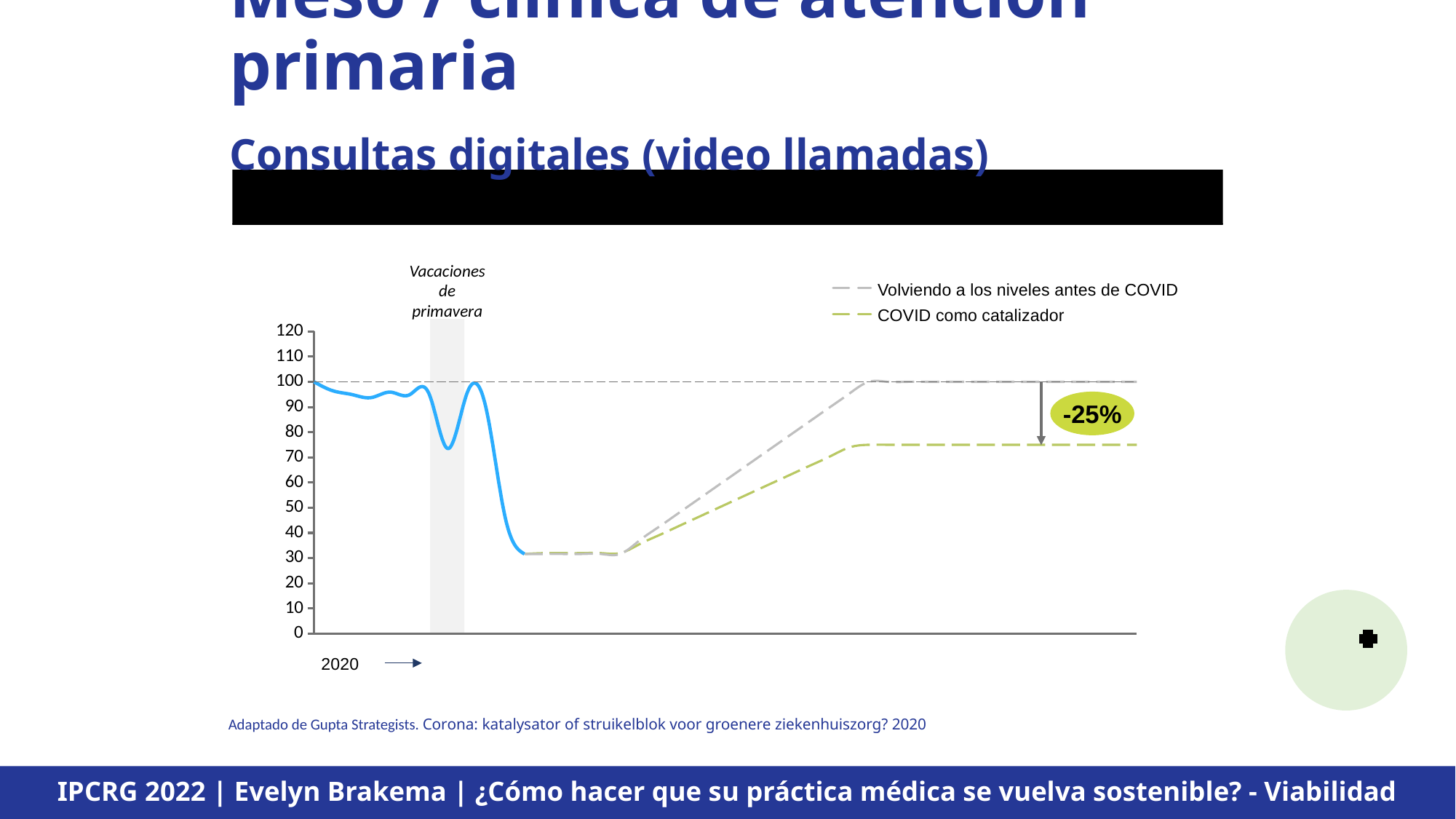
Is the final value of the 'COVID como catalizador' line greater or less than 70? greater Is the final value of the 'COVID como catalizador' line greater or less than 80? less Is the lowest plateau of the blue line after the spring holidays greater or less than 40? less What kind of chart is shown on the slide? line chart What label is given to the shaded vertical band on the chart? Vacaciones de primavera What are the two series named in the legend? Volviendo a los niveles antes de COVID; COVID como catalizador What percentage is printed in the yellow oval annotation on the chart? -25% How many series does the legend list? 2 Which series ends at a higher level on the right of the chart, 'Volviendo a los niveles antes de COVID' or 'COVID como catalizador'? Volviendo a los niveles antes de COVID What is the highest value shown on the y axis? 120 At what level does the 'Volviendo a los niveles antes de COVID' dashed line end on the right of the chart? 100